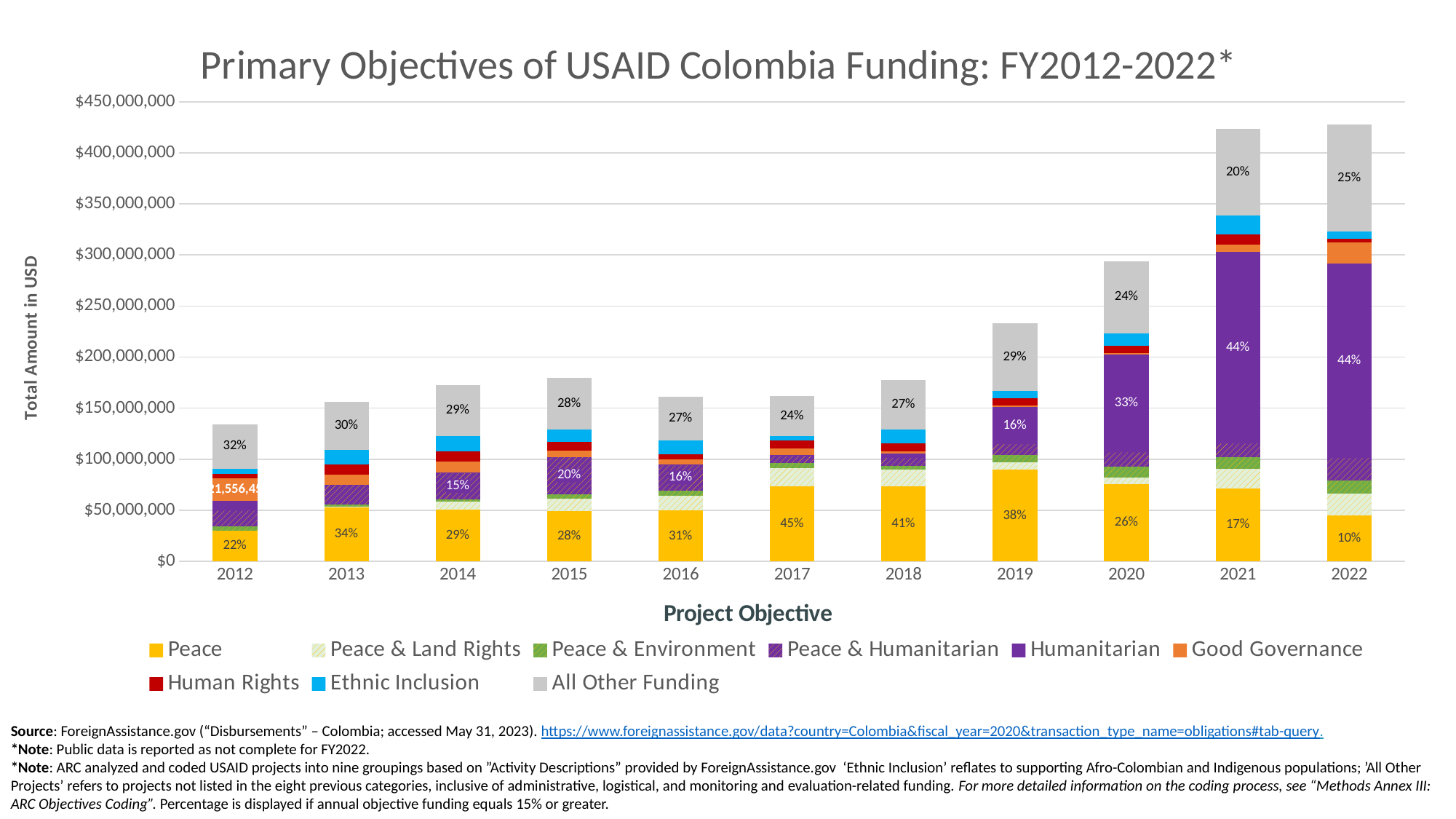
What kind of chart is shown on the slide? Stacked bar chart What percentage label is shown for Humanitarian in 2021? 44% In which year does Peace have the highest labelled percentage share? 2017 In which year does Peace have the lowest labelled percentage share? 2022 What percentage label is shown for Peace in 2017? 45% Does the labelled Peace share rise or fall from 2017 to 2022? Fall What percentage label is shown for All Other Funding in 2012? 32% Is the total bar height for 2022 greater or less than $400,000,000? greater Which is larger: the All Other Funding share in 2012 or in 2021? 2012 How many fiscal years are shown along the x axis? 11 How many series does the legend list? 9 By how many percentage points does the Peace share in 2017 exceed the Peace share in 2022? 35 percentage points